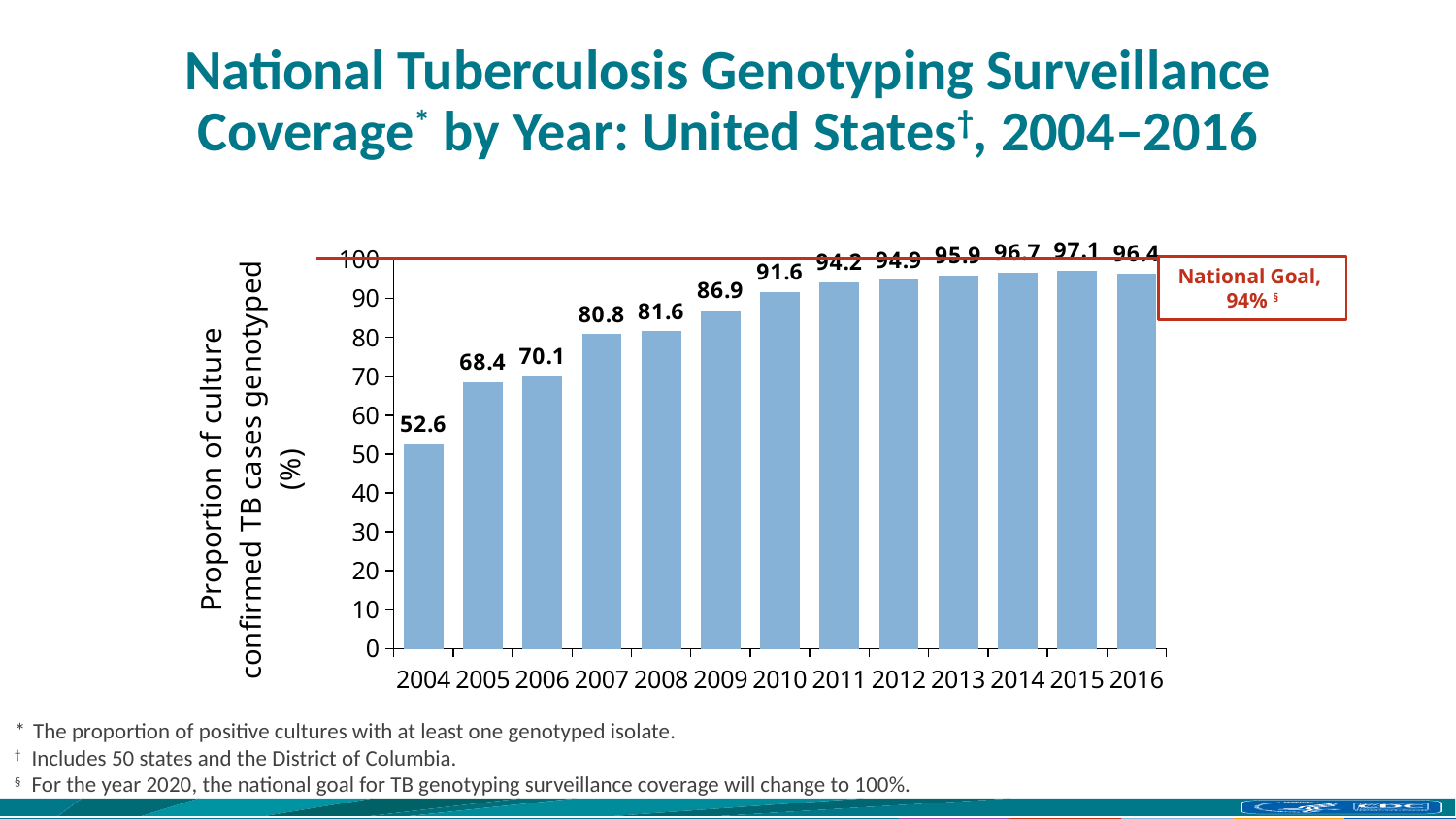
Which year has a larger value, 2007 or 2010? 2010 Which year has the lowest proportion of culture-confirmed TB cases genotyped? 2004 How many years are shown on the x axis? 13 What kind of chart is shown on the slide? Bar chart What is the proportion of culture-confirmed TB cases genotyped in 2004? 52.6 What is the value shown for 2016? 96.4 What national goal is marked by the red line on the chart? 94% What is the value shown for 2009? 86.9 Is the value for 2006 greater or less than 80? less Which year has the highest proportion of culture-confirmed TB cases genotyped? 2015 Do the values generally rise or fall from 2004 to 2015? Rise What is the difference between the values for 2005 and 2004? 15.8